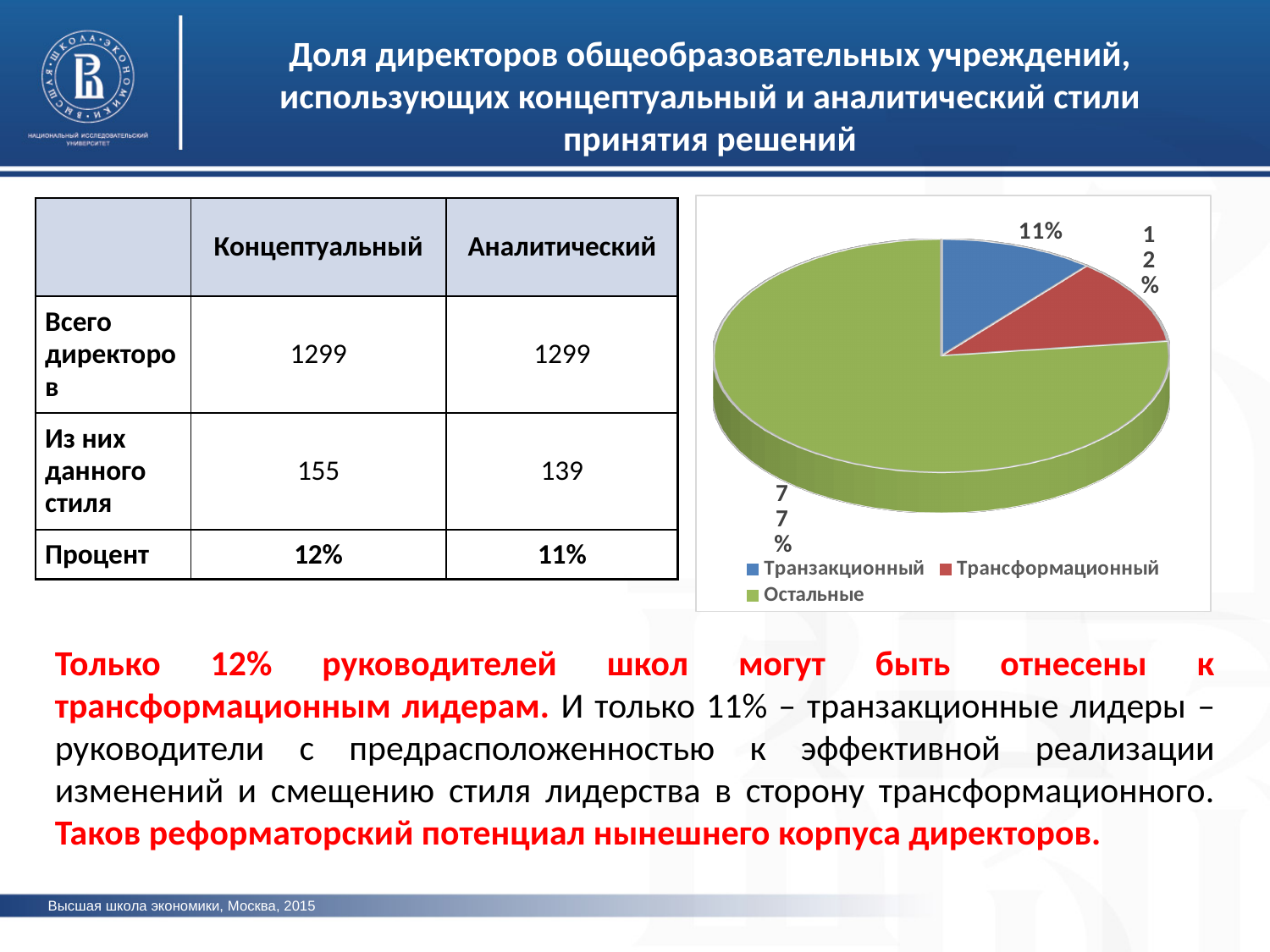
What is the difference in percentage points between the Остальные slice and the Трансформационный slice? 65 How many slices does the pie chart have? 3 Which slice of the pie chart is the smallest? Транзакционный What share of the pie chart is labelled Остальные? 77% What colour is the Остальные slice in the pie chart? green What colour is the Транзакционный slice in the pie chart? blue How many entries does the pie chart's legend list? 3 Which slice of the pie chart is the largest? Остальные What share of the pie chart is labelled Транзакционный? 11% Which is larger in the pie chart: Трансформационный or Транзакционный? Трансформационный What share of the pie chart is labelled Трансформационный? 12% What kind of chart is shown on the slide? pie chart